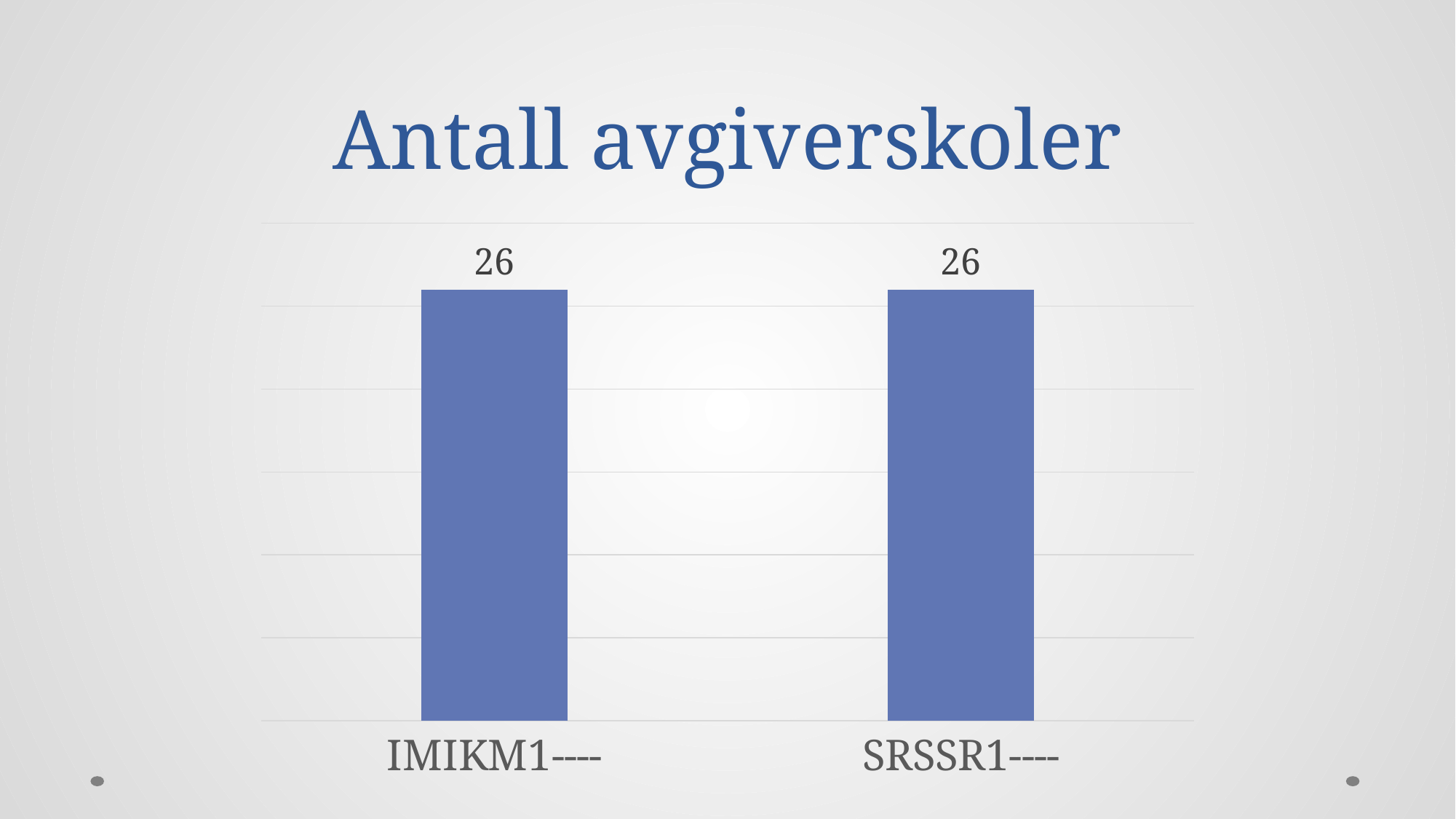
What is the total of the two values shown in the chart? 52 Do the values rise, fall or stay the same from IMIKM1---- to SRSSR1----? stay the same What colour are the bars in the chart? blue What is the value for SRSSR1---- in the chart? 26 What is the title of the chart? Antall avgiverskoler What is the value for IMIKM1---- in the chart? 26 What kind of chart is shown on the slide? bar chart How many categories are shown in the chart? 2 What is the difference between the values for IMIKM1---- and SRSSR1----? 0